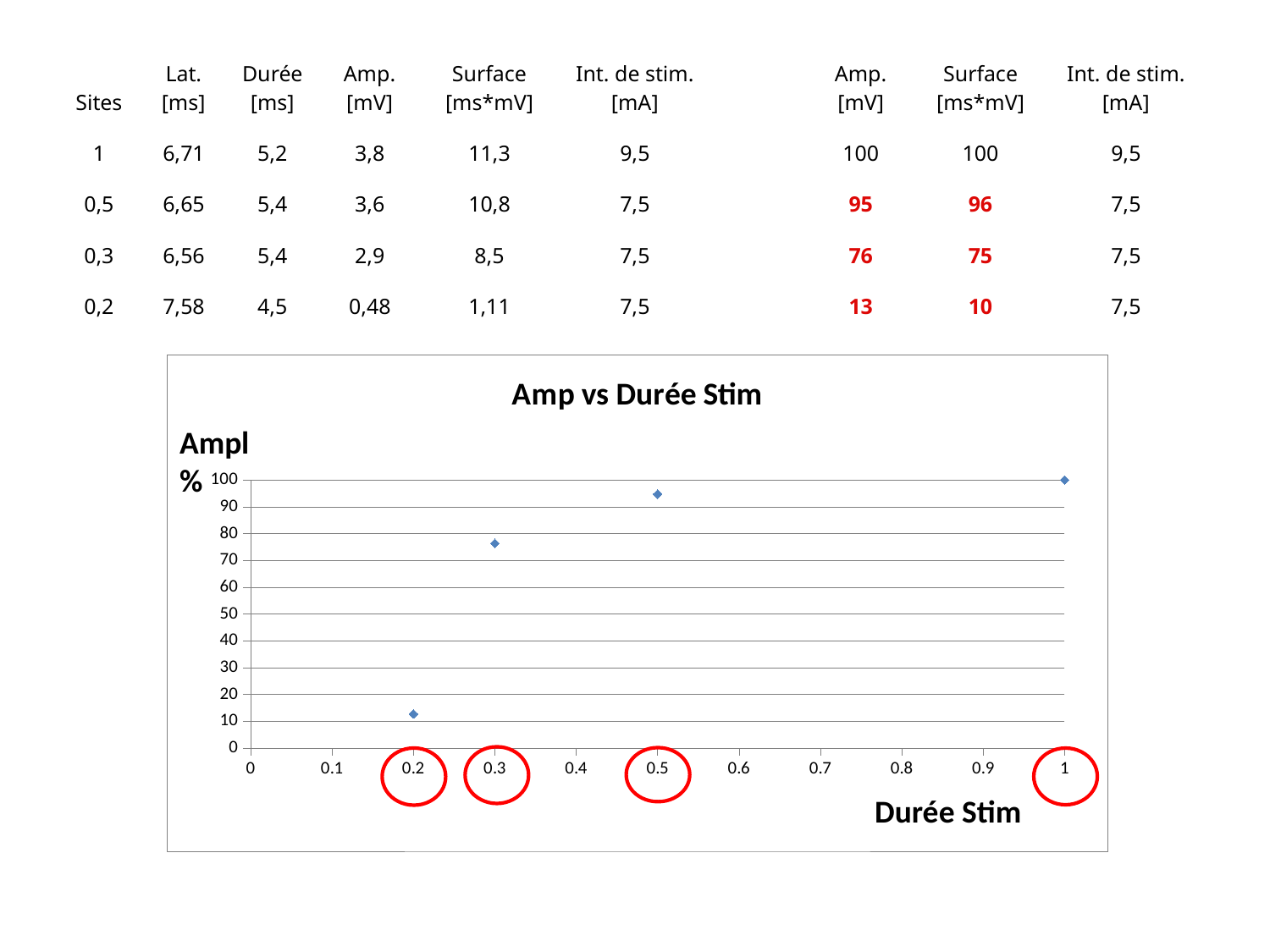
Is the Ampl % value at Durée Stim 0.3 greater or less than 70? greater Is the Ampl % value at Durée Stim 0.5 greater or less than 90? greater How many data points are plotted in the chart? 4 What is the title of the chart? Amp vs Durée Stim What is the Ampl % value plotted at Durée Stim 1? 100 Which has a higher plotted Ampl % value: Durée Stim 0.3 or Durée Stim 0.5? 0.5 What kind of chart is shown on the slide? scatter chart At which Durée Stim value is the plotted Ampl % lowest? 0.2 What is the label of the x axis of the chart? Durée Stim Do the plotted Ampl % values rise or fall as Durée Stim increases? rise Is the Ampl % value at Durée Stim 0.2 greater or less than 20? less At which Durée Stim value is the plotted Ampl % highest? 1